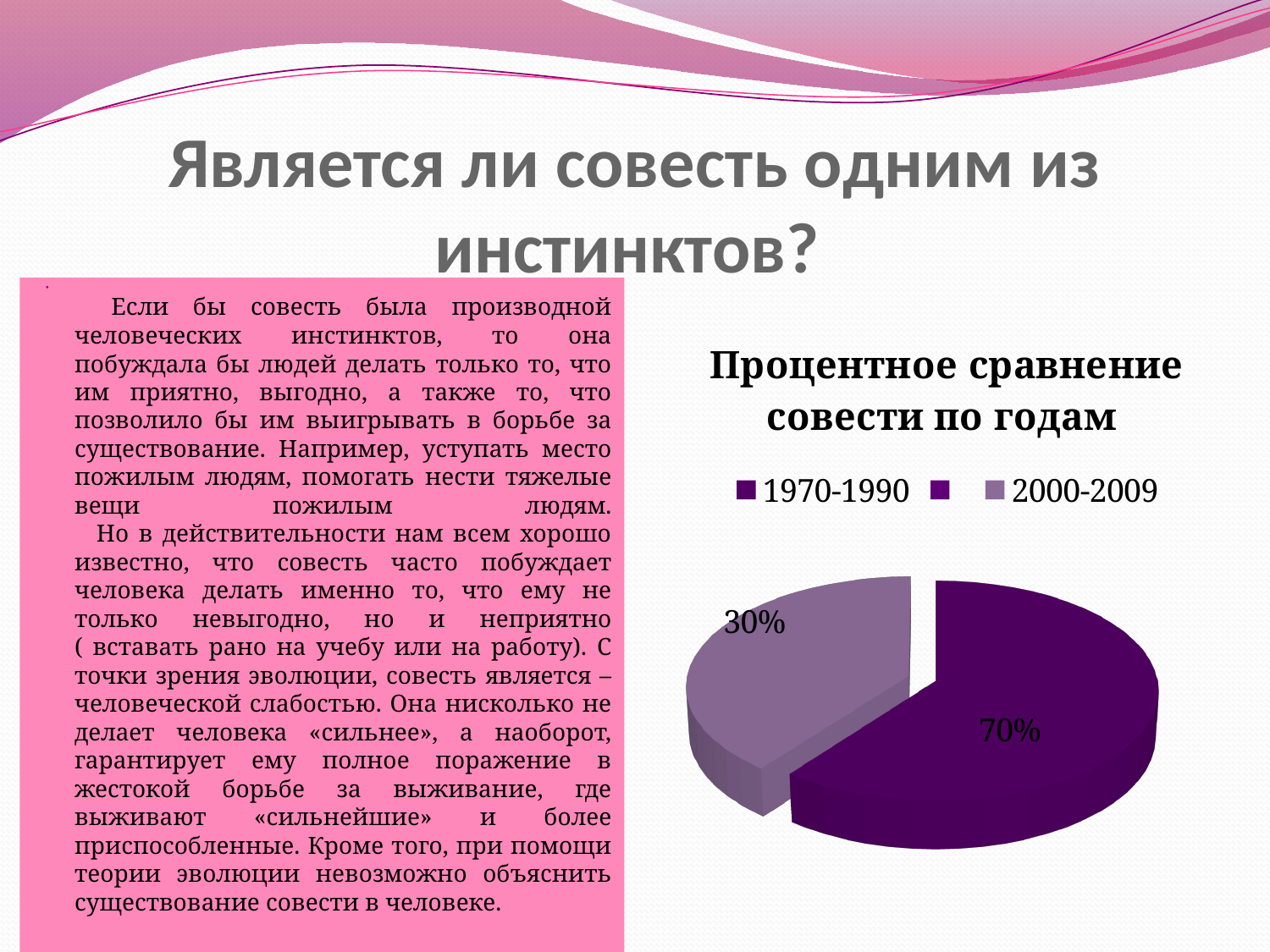
What is the difference in percentage points between the 1970-1990 slice and the 2000-2009 slice? 40 What is the title of the chart? Процентное сравнение совести по годам What percentage is shown for the 1970-1990 slice? 70% Which period has the smallest slice of the pie? 2000-2009 Which legend entry is shown in the darkest purple colour? 1970-1990 Which period has the largest slice of the pie? 1970-1990 What percentage is shown for the 2000-2009 slice? 30% What kind of chart is shown on the slide? pie chart How many slices with data labels are visible in the pie chart? 2 What share of the pie does the 2000-2009 slice represent? 30% Which is larger, the 1970-1990 slice or the 2000-2009 slice? 1970-1990